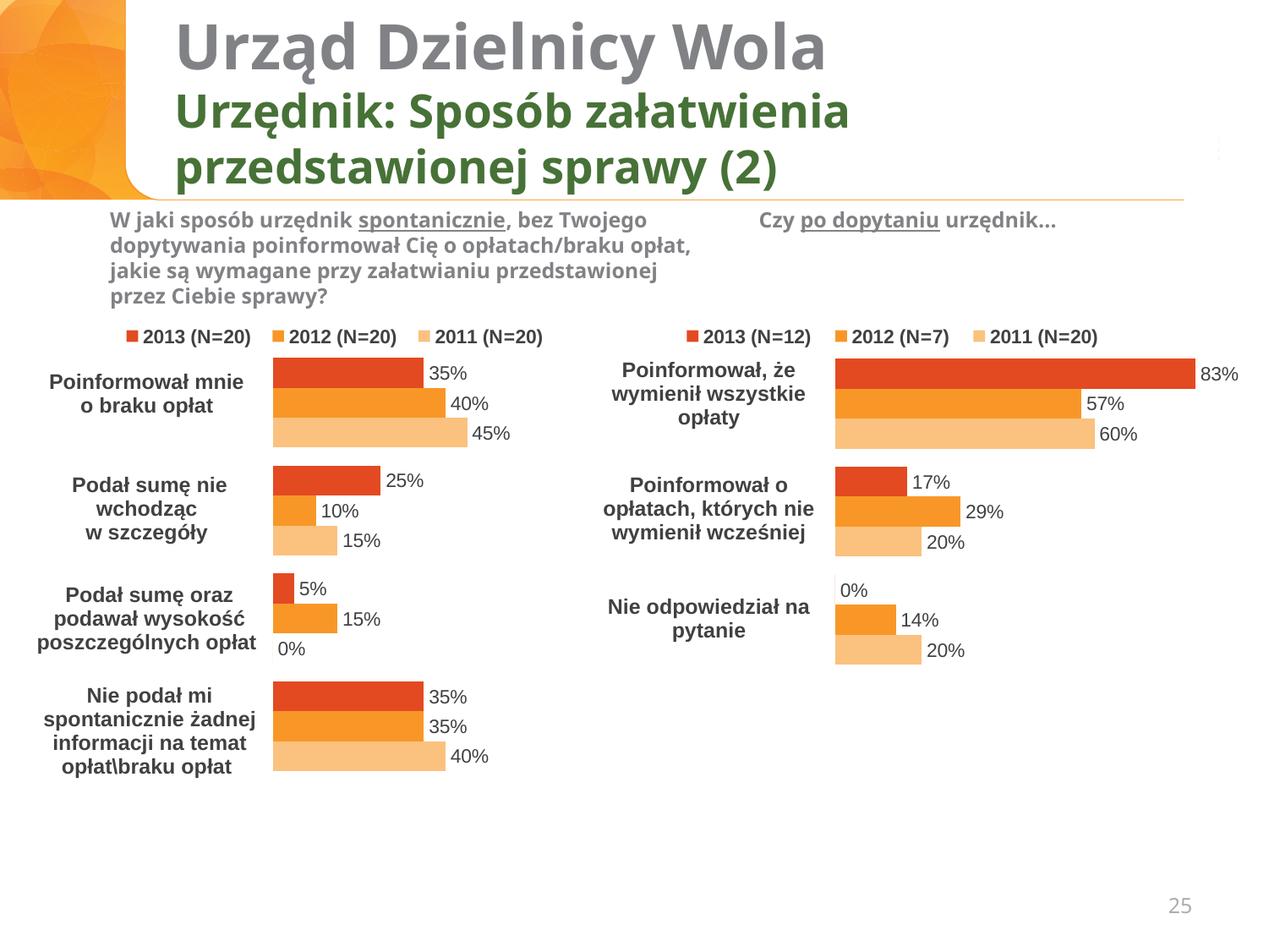
How many categories does the left chart show? 4 In the left chart, what is the 2011 (N=20) value for 'Podał sumę nie wchodząc w szczegóły'? 15% What kind of chart is the right chart? Bar chart In the left chart, which is larger for 'Podał sumę nie wchodząc w szczegóły': the 2013 (N=20) value or the 2012 (N=20) value? 2013 (N=20) In the left chart, which category has the lowest 2013 (N=20) value? Podał sumę oraz podawał wysokość poszczególnych opłat In the right chart, which category has the highest 2011 (N=20) value? Poinformował, że wymienił wszystkie opłaty In the left chart, what is the 2011 (N=20) value for 'Podał sumę oraz podawał wysokość poszczególnych opłat'? 0% How many series does the legend of the right chart list? 3 In the right chart, what is the 2012 (N=7) value for 'Nie odpowiedział na pytanie'? 14% In the right chart, what is the difference between the 2013 (N=12) and 2012 (N=7) values for 'Poinformował, że wymienił wszystkie opłaty'? 26% In the left chart, what is the 2013 (N=20) value for 'Poinformował mnie o braku opłat'? 35% In the right chart, what is the 2013 (N=12) value for 'Poinformował, że wymienił wszystkie opłaty'? 83%